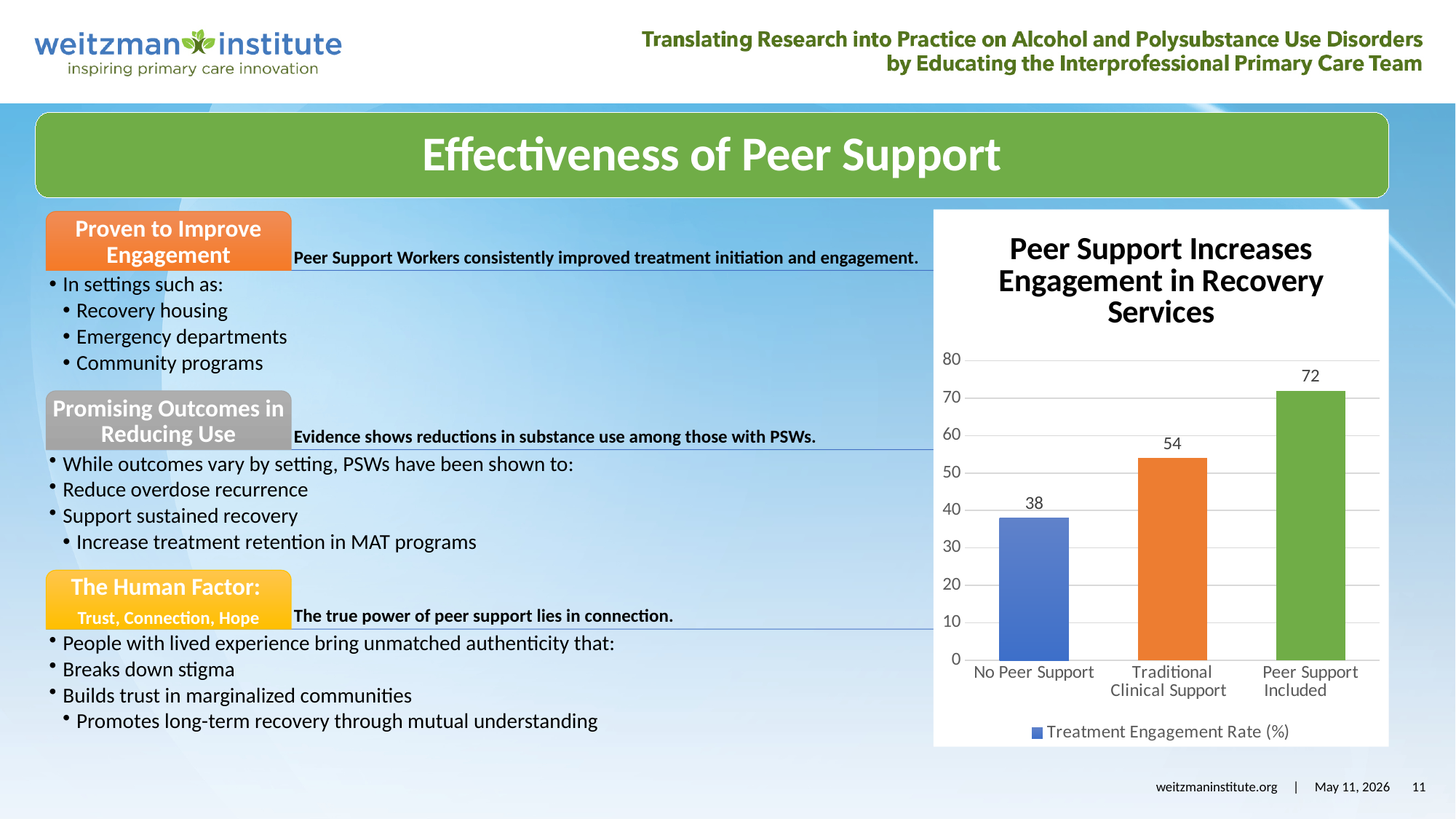
Which has a higher treatment engagement rate, Traditional Clinical Support or Peer Support Included? Peer Support Included What is the treatment engagement rate for Peer Support Included? 72 What is the treatment engagement rate for Traditional Clinical Support? 54 Which category has the lowest treatment engagement rate? No Peer Support What kind of chart is shown on the slide? bar chart What is the title of the chart? Peer Support Increases Engagement in Recovery Services How many categories are shown in the chart? 3 Is the value for No Peer Support greater or less than 40? less What is the difference between the treatment engagement rate for Traditional Clinical Support and No Peer Support? 16 Which category has the highest treatment engagement rate? Peer Support Included What is the treatment engagement rate for No Peer Support? 38 What is the difference between the treatment engagement rate for Peer Support Included and No Peer Support? 34